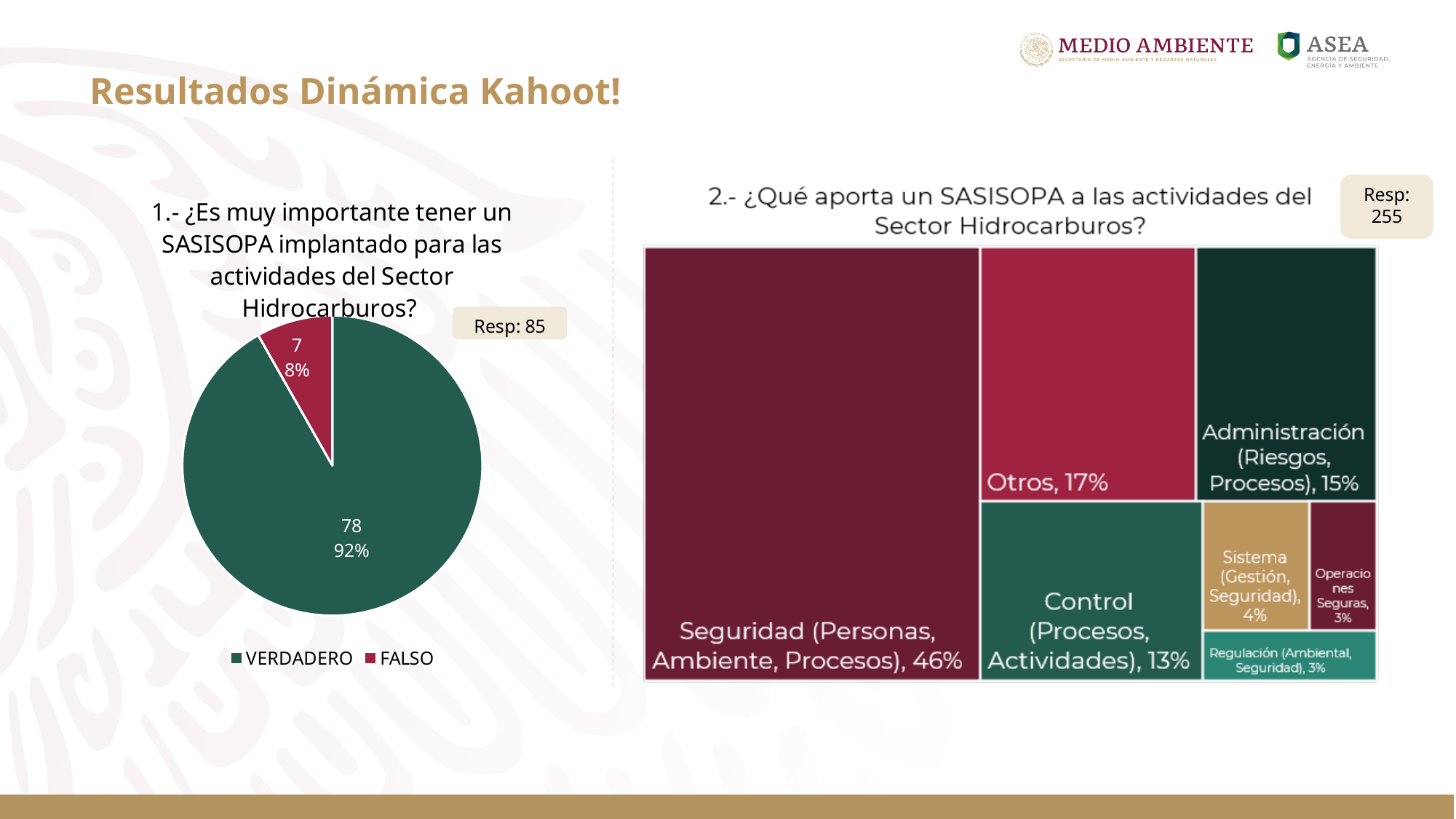
On the right treemap chart, what is the difference in percentage between Administración (Riesgos, Procesos) and Control (Procesos, Actividades)? 2% On the left pie chart, how many responses were VERDADERO? 78 What kind of chart is the chart on the left of the slide? Pie chart What is the number of responses (Resp) shown next to the right treemap chart? 255 On the right treemap chart, what percentage is shown for Otros? 17% On the left pie chart, what percentage of responses were FALSO? 8% On the left pie chart, what is the difference between the VERDADERO and FALSO counts? 71 How many entries does the legend of the left pie chart list? 2 How many categories are shown on the right treemap chart? 7 On the left pie chart, which category has the larger slice, VERDADERO or FALSO? VERDADERO On the right treemap chart, which category has the highest percentage? Seguridad (Personas, Ambiente, Procesos) On the left pie chart, what share of the pie does VERDADERO represent? 92%